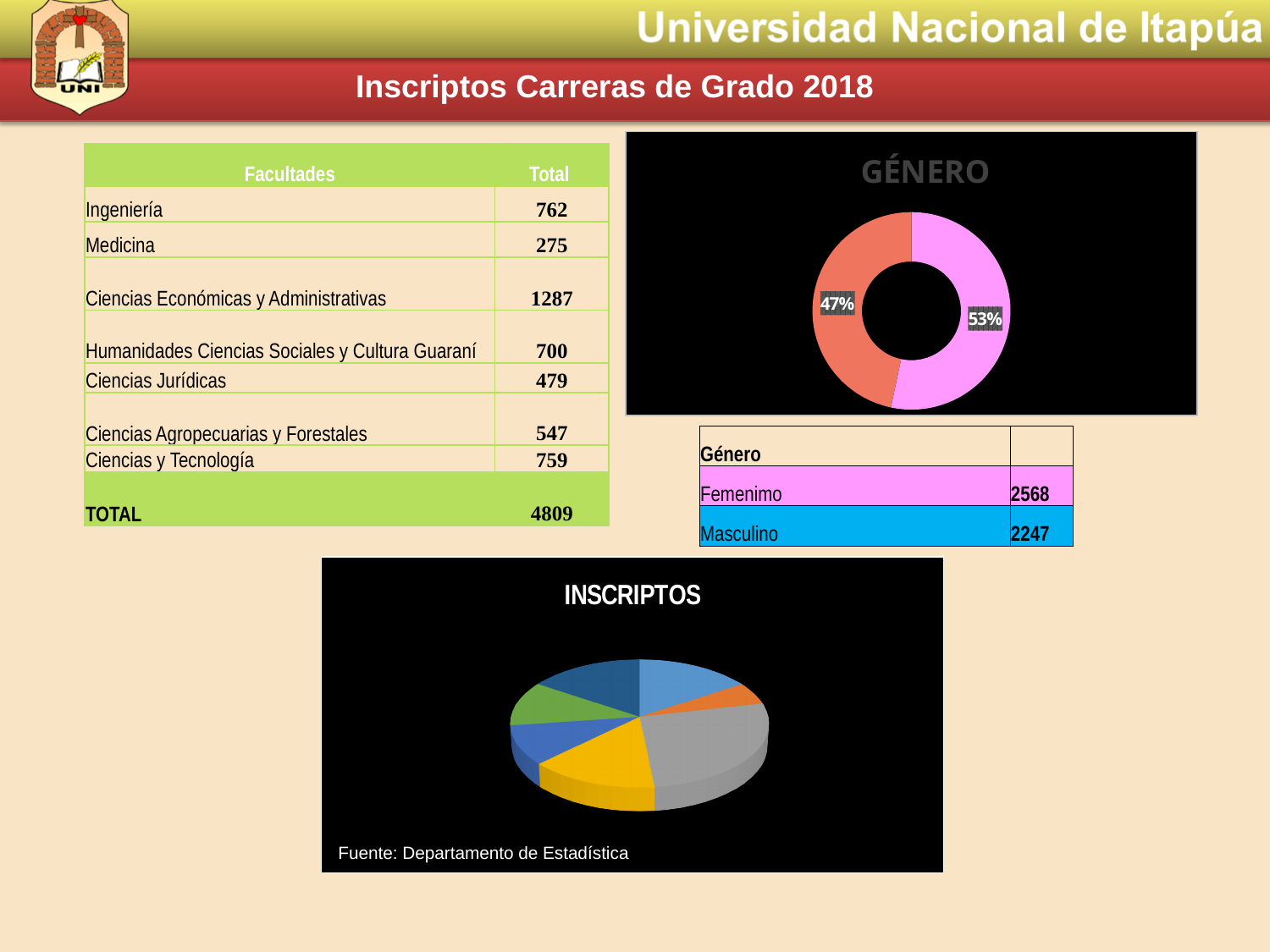
What kind of chart is the GÉNERO chart? doughnut chart In the GÉNERO chart, is the share of the pink slice greater or less than 50%? greater How many slices does the GÉNERO doughnut chart have? 2 In the GÉNERO chart, what is the difference between the two slices' percentages? 6% What source is cited below the INSCRIPTOS pie chart? Fuente: Departamento de Estadística In the GÉNERO chart, what share does the smaller (orange) slice represent? 47% How many slices does the INSCRIPTOS pie chart have? 7 What is the title of the pie chart at the bottom of the slide? INSCRIPTOS In the GÉNERO chart, is the pink slice larger or smaller than the orange slice? larger In the GÉNERO chart, what share does the larger (pink) slice represent? 53% What kind of chart is the INSCRIPTOS chart at the bottom of the slide? pie chart In the GÉNERO chart, which slice is the largest, the pink one or the orange one? the pink one